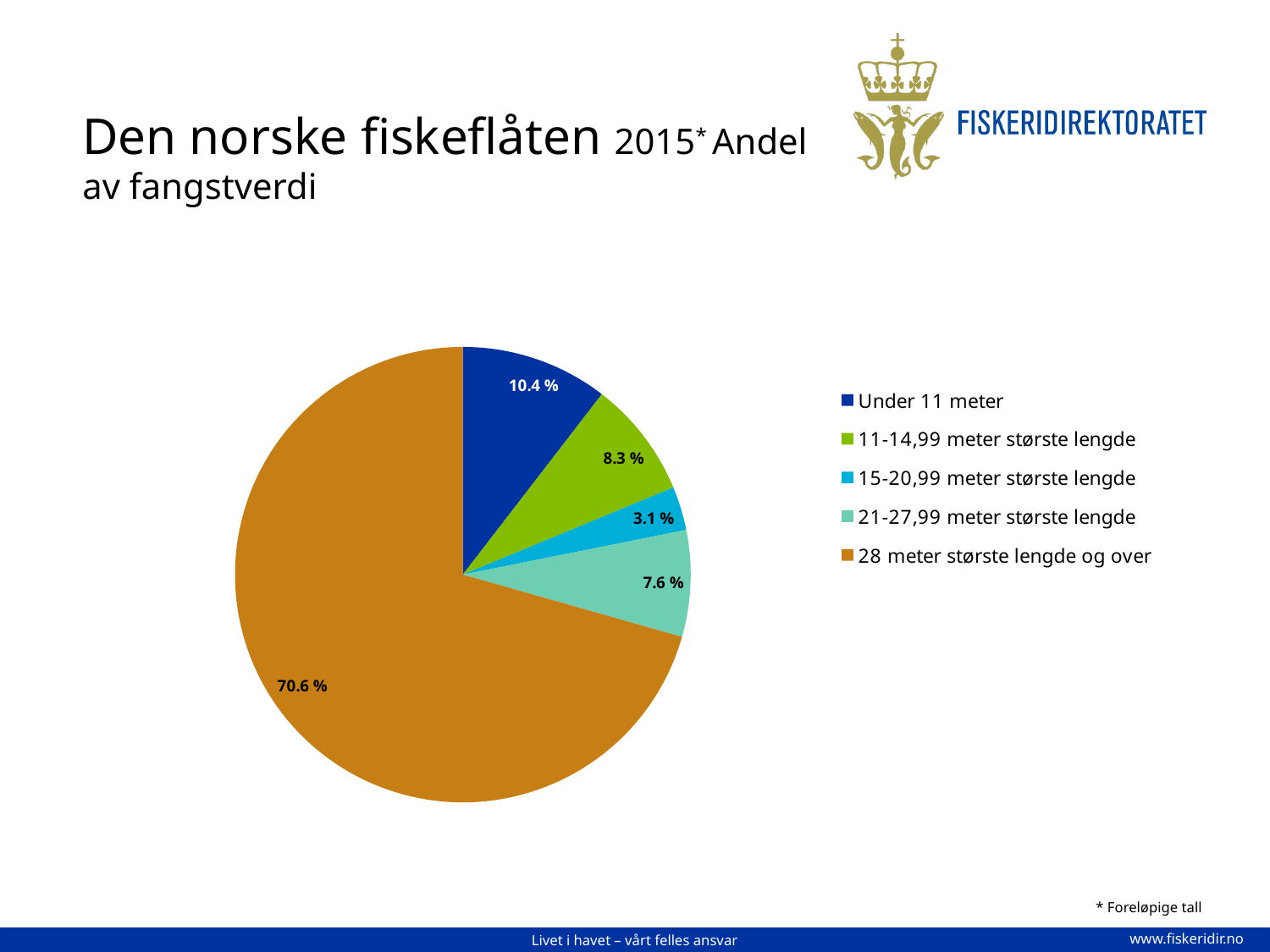
Which has a larger share: '21-27,99 meter største lengde' or '15-20,99 meter største lengde'? 21-27,99 meter største lengde Which category has the smallest share of the catch value? 15-20,99 meter største lengde What share of the catch value does the '15-20,99 meter største lengde' category account for? 3.1 % How many categories are shown in the pie chart? 5 What type of chart is shown on the slide? Pie chart Which category has the largest share of the catch value? 28 meter største lengde og over What share of the catch value does the '11-14,99 meter største lengde' category account for? 8.3 % What colour is the slice for '28 meter største lengde og over'? Orange/brown What share of the catch value does the 'Under 11 meter' category account for? 10.4 % What share of the catch value does the '21-27,99 meter største lengde' category account for? 7.6 % What is the difference in percentage points between the 'Under 11 meter' share and the '11-14,99 meter største lengde' share? 2.1 percentage points What share of the catch value does the '28 meter største lengde og over' category account for? 70.6 %